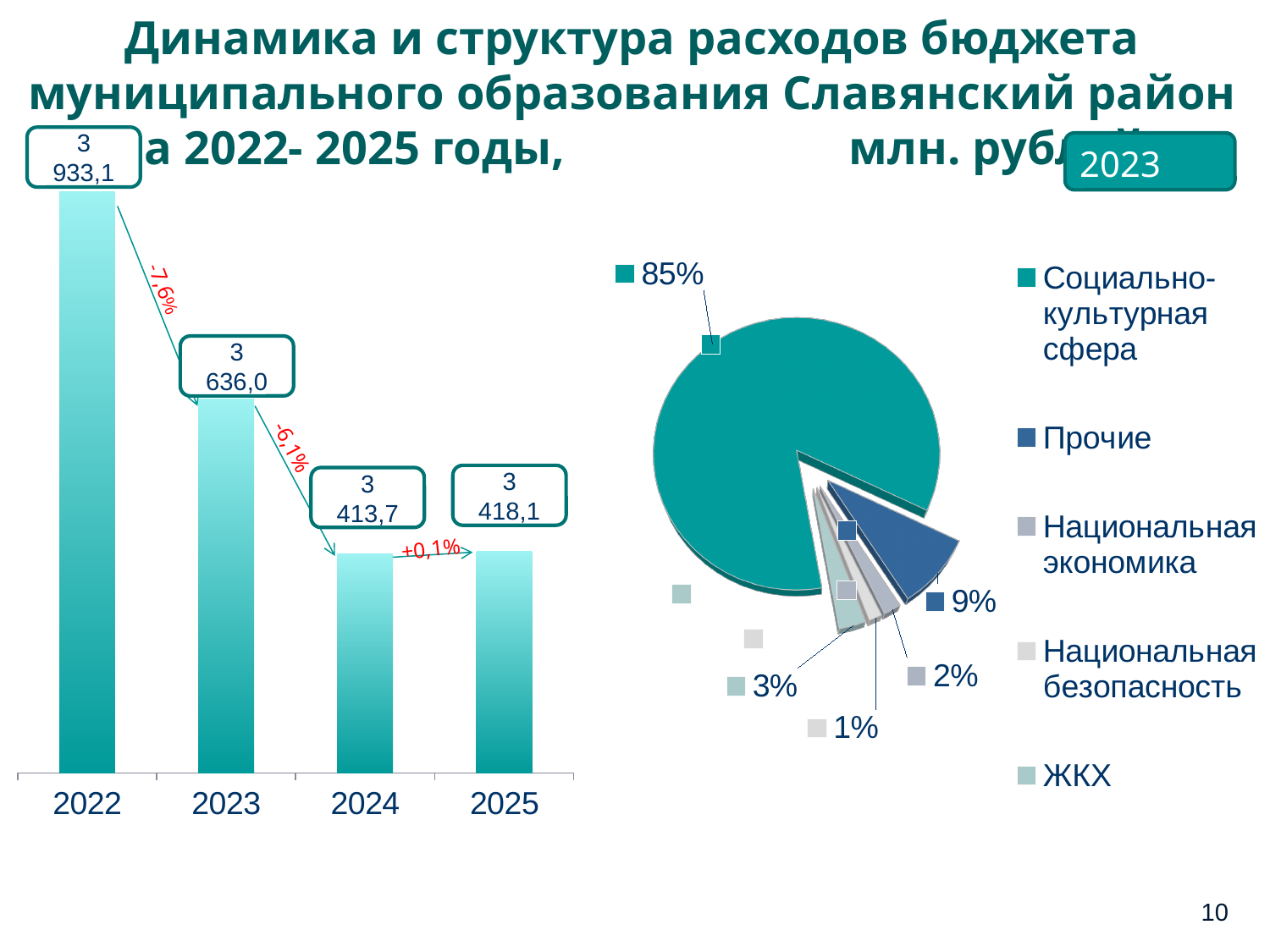
What kind of chart is on the right side of the slide? pie chart How many entries does the legend of the pie chart on the right list? 5 In the bar chart on the left, how many years are shown on the x axis? 4 In the bar chart on the left, which year has the lowest value? 2024 In the bar chart on the left, what is the value for 2024? 3 413,7 In the bar chart on the left, which year has the highest value? 2022 In the bar chart on the left, which is larger, the value for 2024 or the value for 2025? 2025 In the pie chart on the right, what share does ЖКХ have? 3% In the pie chart on the right, what share does Социально-культурная сфера have? 85% In the bar chart on the left, what is the difference between the values for 2022 and 2023? 297,1 In the bar chart on the left, what is the value for 2022? 3 933,1 In the bar chart on the left, what percentage change is shown between 2023 and 2024? -6,1%